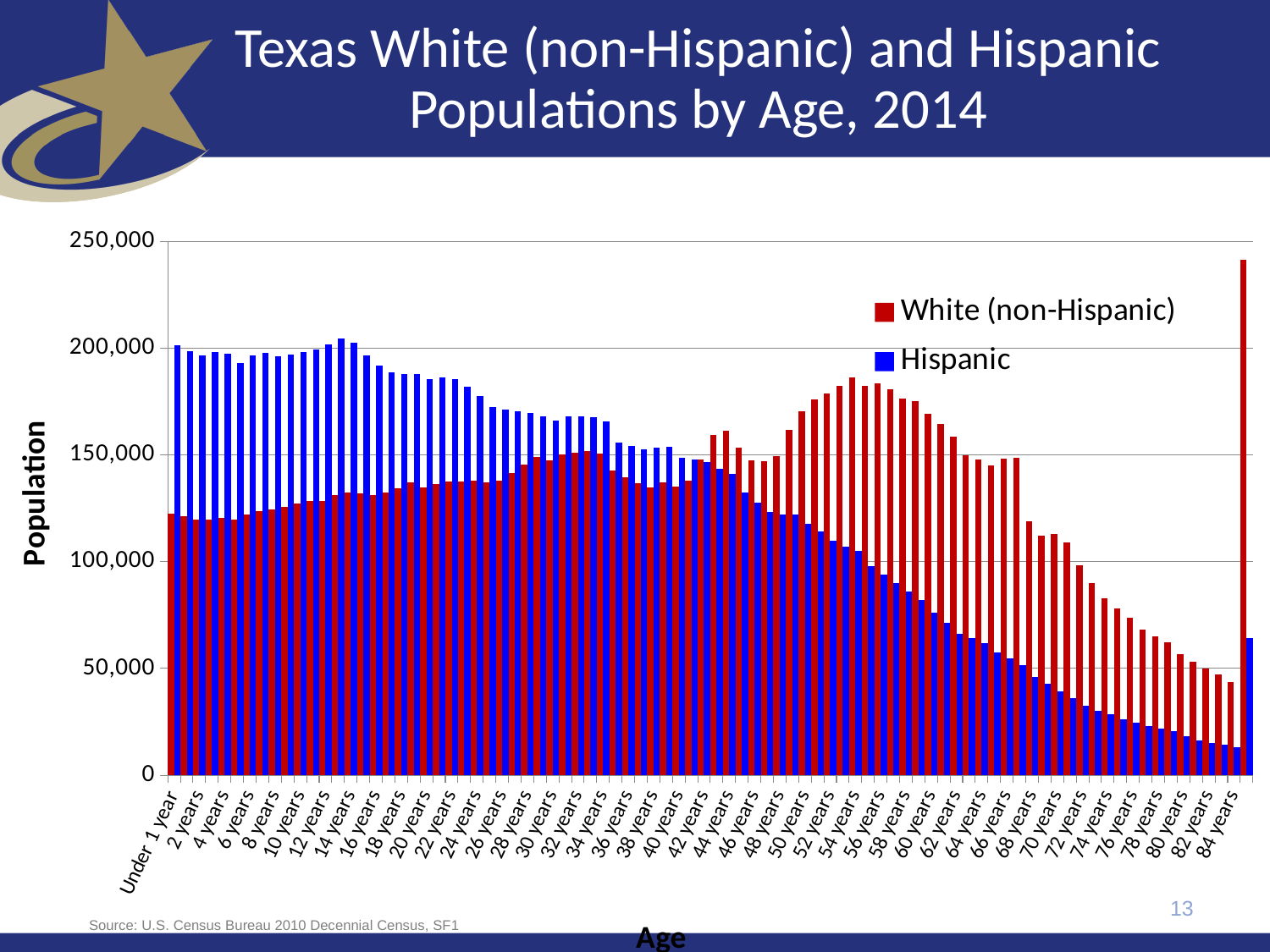
Is the White (non-Hispanic) value for 70 years greater or less than 100,000? greater Is the Hispanic value for 70 years greater or less than 50,000? less Do the Hispanic values generally rise or fall as age increases from 20 years to 84 years? Fall At 54 years, which series has the larger value, White (non-Hispanic) or Hispanic? White (non-Hispanic) Is the Hispanic value for 84 years greater or less than 50,000? less How many series does the legend list? 2 At 2 years, which series has the larger value, White (non-Hispanic) or Hispanic? Hispanic Which colour represents the Hispanic series in the chart? Blue What is the title of the vertical axis? Population What kind of chart is shown on the slide? Bar chart